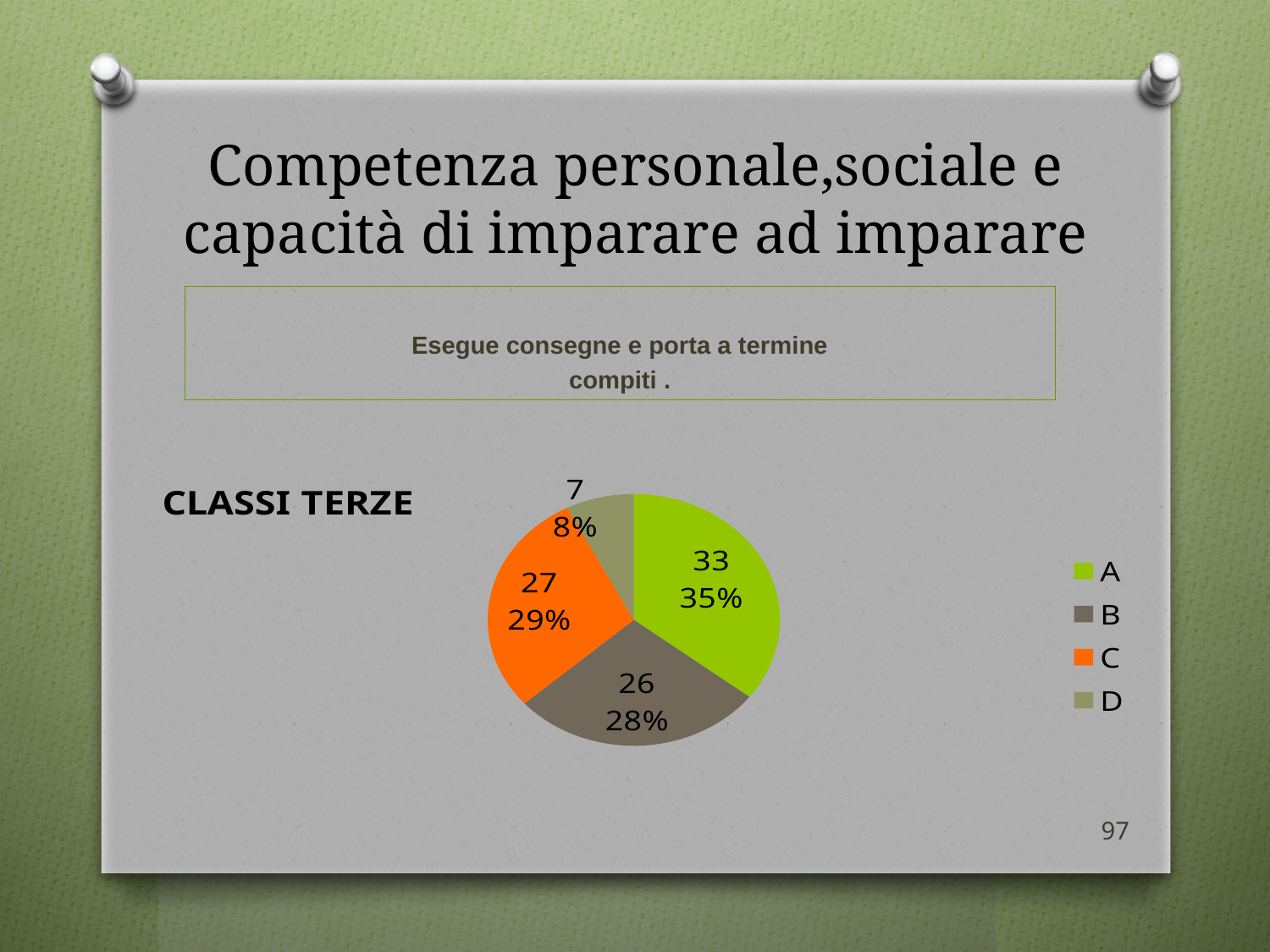
What percentage share does category B have? 28% What is the total of all the values shown in the pie chart? 93 Which category has the largest slice? A Which category has the smallest slice? D What is the value for category D? 7 How many categories does the legend list? 4 What percentage share does category C have? 29% What kind of chart is shown on the slide? pie chart What is the difference between the values for A and B? 7 Which is larger, the value for C or the value for B? C What is the value for category A? 33 What colour is the slice for category C? orange